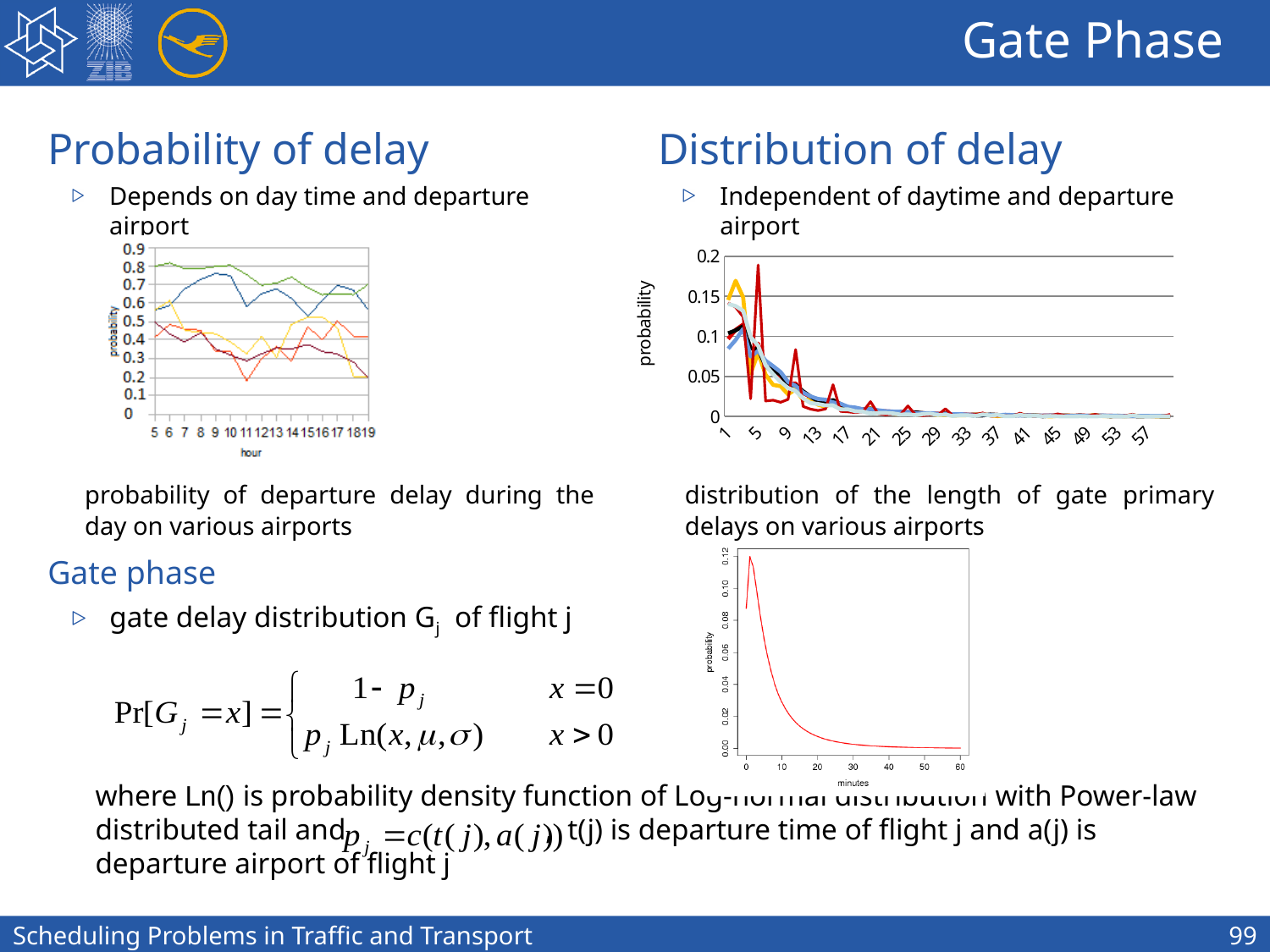
In the bottom-right chart of probability against minutes, is the value at 40 minutes greater or less than 0.02? less What kind of chart is the 'probability of departure delay during the day on various airports' chart on the left? line chart In the bottom-right chart of probability against minutes, what is the highest value shown on the y axis? 0.12 What kind of chart is the 'distribution of the length of gate primary delays on various airports' chart on the right? line chart In the left chart (probability of departure delay during the day), is the value of the dark red line at hour 11 greater or less than 0.4? less In the left chart (probability of departure delay during the day), what is the label of the x axis? hour In the left chart (probability of departure delay during the day), how many hour ticks are shown on the x axis? 15 In the right chart (distribution of the length of gate primary delays), do the values generally rise or fall as the x axis increases? fall In the left chart (probability of departure delay during the day), what is the highest value shown on the y axis? 0.9 In the right chart (distribution of the length of gate primary delays), are the values at x = 41 greater or less than 0.05? less